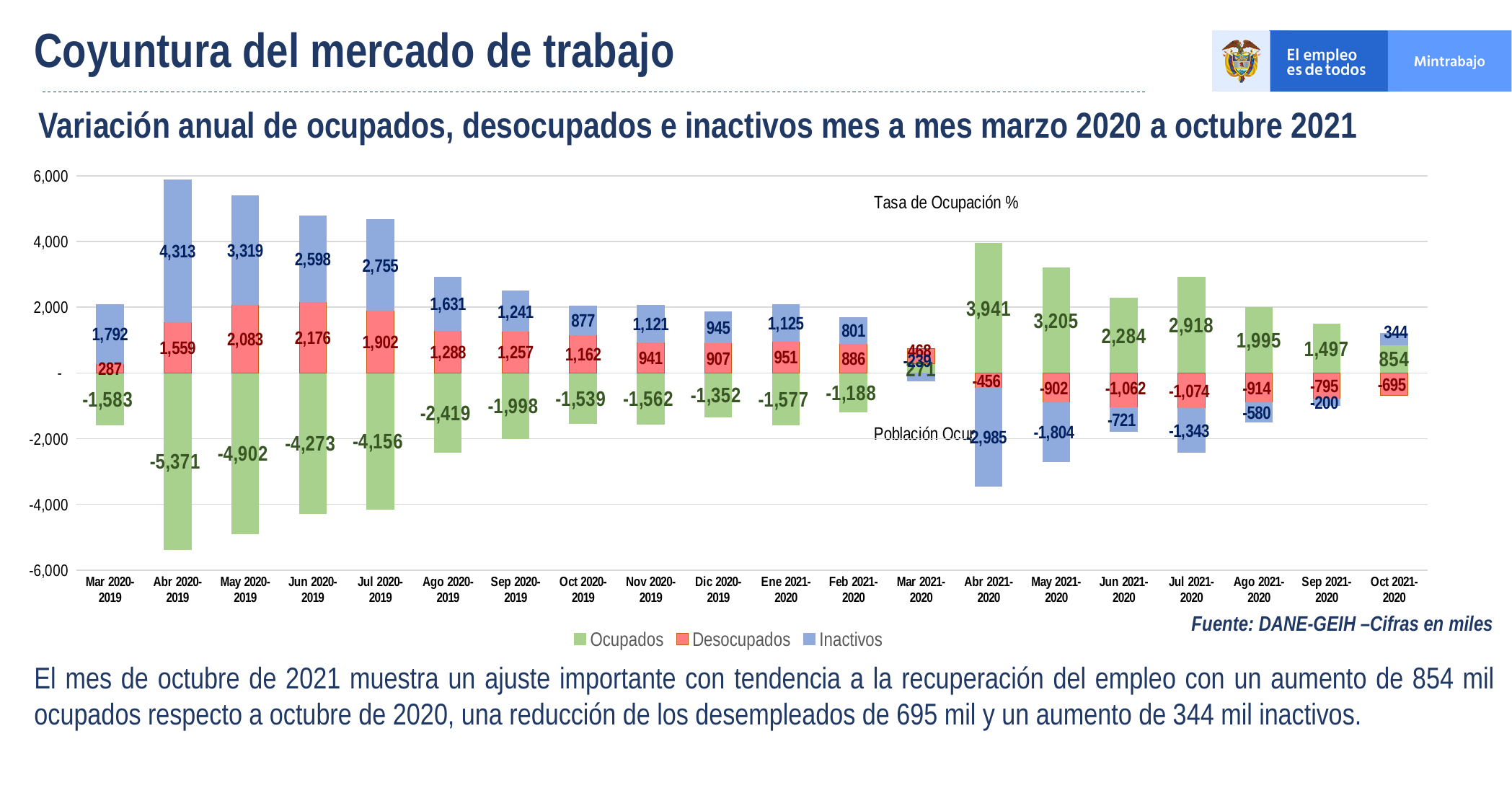
What is the value of Ocupados for Abr 2021-2020? 3,941 What kind of chart is shown? Stacked bar chart What is the difference between the Ocupados values for Abr 2021-2020 and May 2021-2020? 736 How many series does the legend list? 3 In which period is the Ocupados value lowest? Abr 2020-2019 What is the value of Inactivos for Abr 2020-2019? 4,313 How many periods are shown on the x axis? 20 In which period is the Inactivos value highest? Abr 2020-2019 What is the value of Ocupados for Oct 2021-2020? 854 What is the value of Desocupados for Jun 2020-2019? 2,176 Which is larger, the Desocupados value for Jun 2020-2019 or for May 2020-2019? Jun 2020-2019 Do the Ocupados values rise or fall from Jul 2021-2020 to Oct 2021-2020? Fall